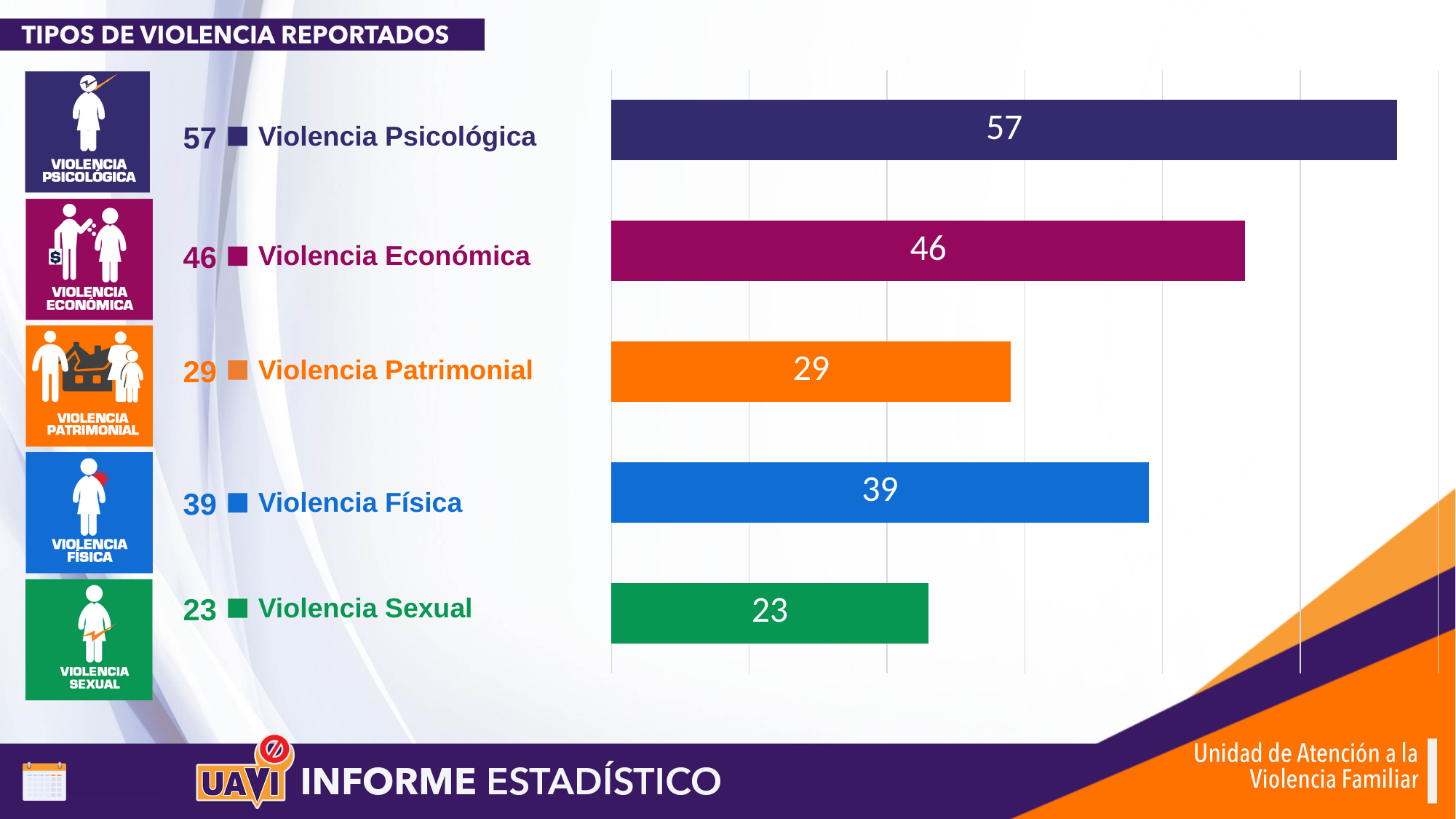
What is the value for Violencia Sexual? 23 What is the difference between Violencia Psicológica and Violencia Económica? 11 What kind of chart is shown on the slide? Bar chart Which is larger, Violencia Física or Violencia Patrimonial? Violencia Física How many types of violence are shown in the chart? 5 What is the value for Violencia Psicológica? 57 Which type of violence has the lowest value? Violencia Sexual What is the total of all five values shown in the chart? 194 What is the difference between Violencia Física and Violencia Patrimonial? 10 Which type of violence has the highest value? Violencia Psicológica What is the value for Violencia Económica? 46 What is the title of the slide? TIPOS DE VIOLENCIA REPORTADOS